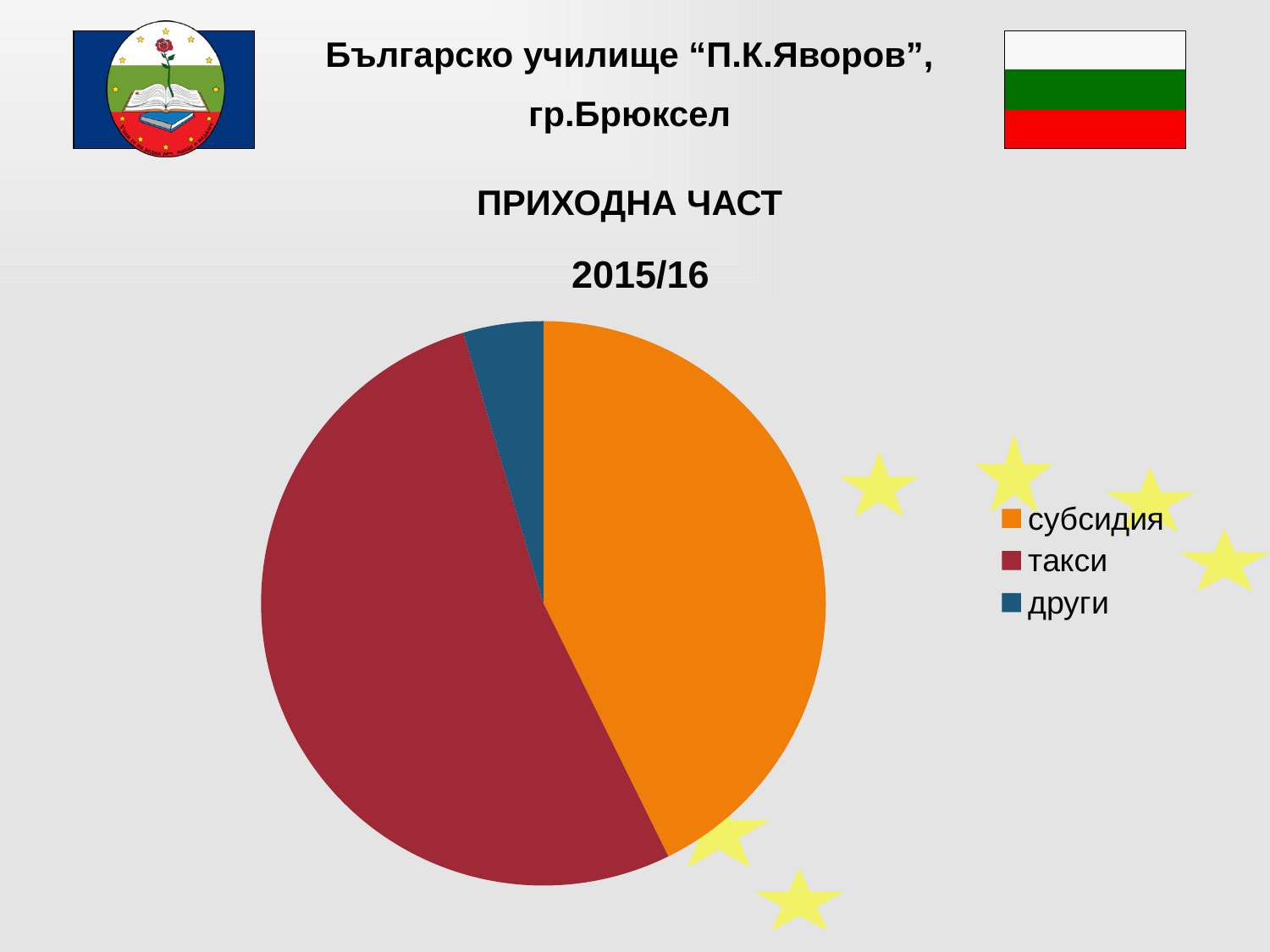
Which slice is smaller, субсидия or други? други Which slice is larger, субсидия or такси? такси What is the title of the pie chart? 2015/16 Which category has the largest slice of the pie chart? такси What colour is the слице for такси in the pie chart? red How many entries does the legend of the pie chart list? 3 Which category has the smallest slice of the pie chart? други Which slice is larger, такси or други? такси How many slices does the pie chart have? 3 What kind of chart is shown on the slide? pie chart